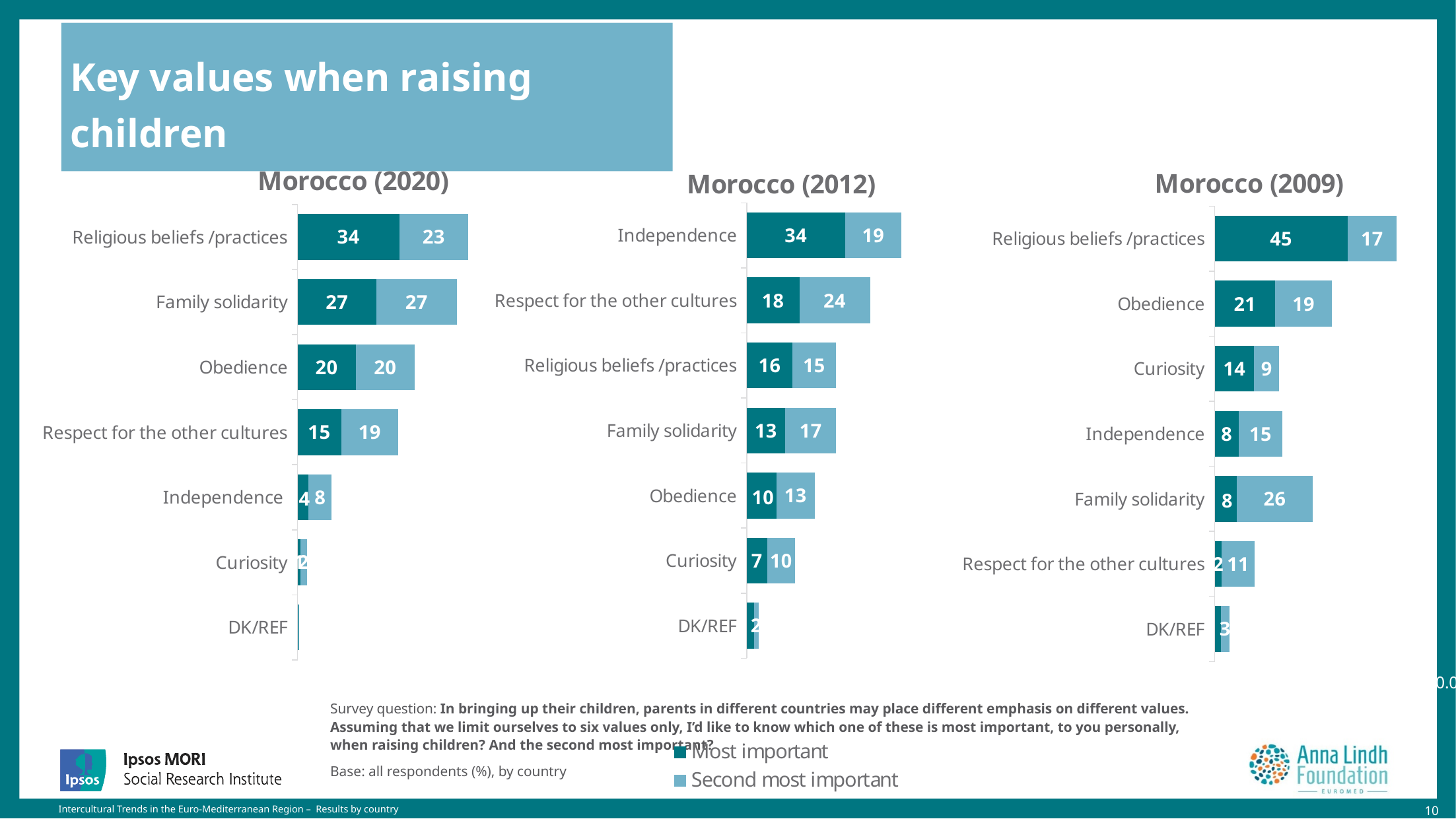
In the Morocco (2009) chart, what is the 'Second most important' value for Family solidarity? 26 In the Morocco (2020) chart, what is the total of the stacked bar for Family solidarity? 54 In the Morocco (2009) chart, which has the larger 'Second most important' value: Family solidarity or Independence? Family solidarity How many categories are listed in the Morocco (2020) chart? 7 In the Morocco (2020) chart, what is the 'Most important' value for Religious beliefs /practices? 34 What kind of chart is the Morocco (2012) chart? Stacked bar chart How many series does the legend list for these charts? 2 In the Morocco (2009) chart, what is the 'Most important' value for Religious beliefs /practices? 45 In the Morocco (2009) chart, which category has the highest 'Most important' value? Religious beliefs /practices In the Morocco (2012) chart, which category has the highest 'Most important' value? Independence In the Morocco (2012) chart, what is the 'Second most important' value for Respect for the other cultures? 24 In the Morocco (2012) chart, what is the difference between the 'Most important' and 'Second most important' values for Independence? 15